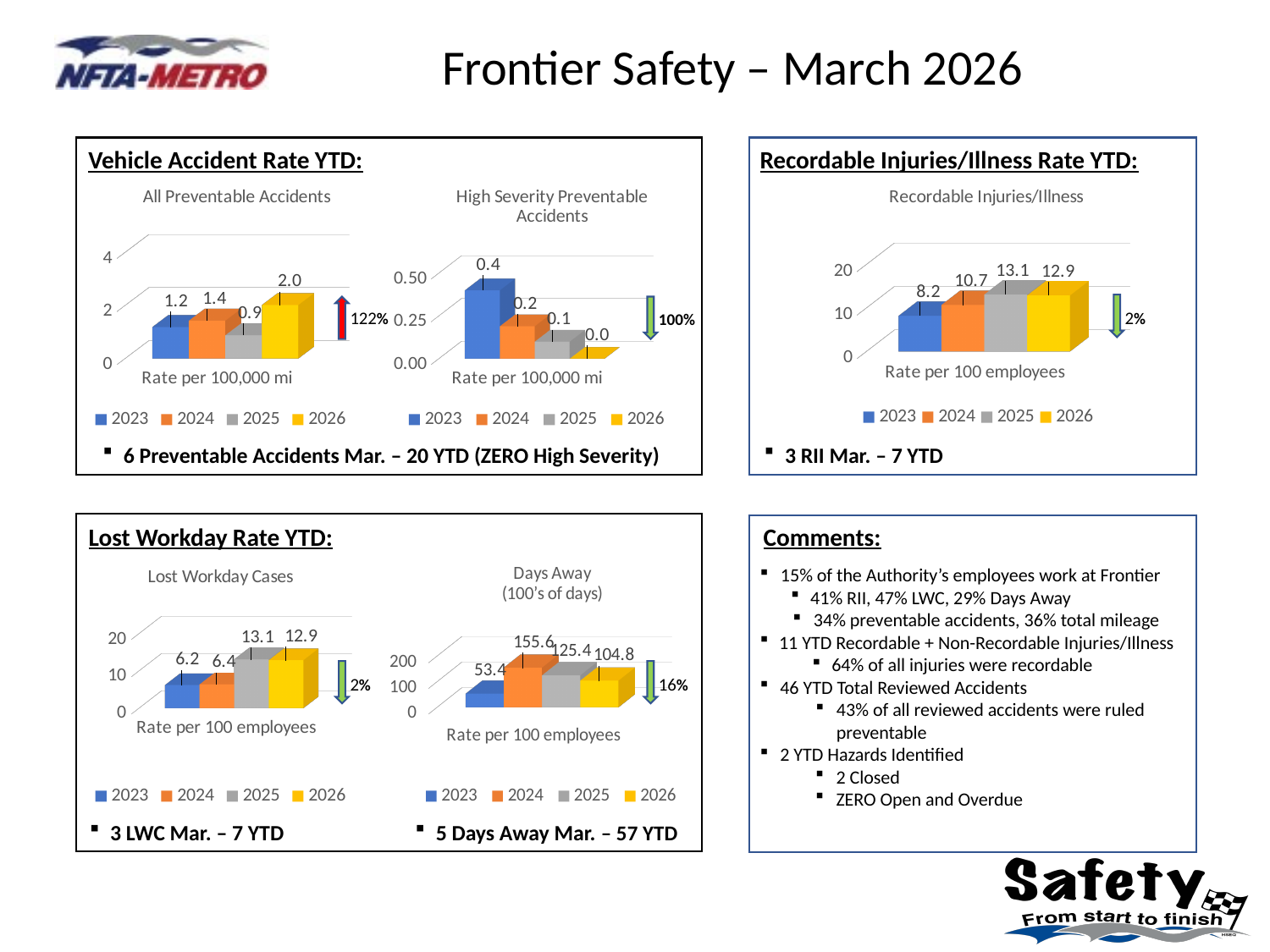
How many series does the legend of the 'Lost Workday Cases' chart list? 4 In the 'All Preventable Accidents' chart, what is the value for 2026? 2.0 In the 'Recordable Injuries/Illness' chart, what is the value for 2024? 10.7 In the 'Days Away (100's of days)' chart, what is the value for 2026? 104.8 In the 'Recordable Injuries/Illness' chart, which year has the highest rate? 2025 In the 'Lost Workday Cases' chart, which is larger, the value for 2024 or the value for 2026? 2026 In the 'All Preventable Accidents' chart, which year has the lowest rate? 2025 In the 'High Severity Preventable Accidents' chart, do the values rise or fall from 2023 to 2026? fall In the 'Recordable Injuries/Illness' chart, what is the difference between the 2025 and 2023 values? 4.9 In the 'Lost Workday Cases' chart, what is the value for 2023? 6.2 In the 'High Severity Preventable Accidents' chart, what is the value for 2023? 0.4 In the 'Days Away (100's of days)' chart, which year has the highest value? 2024